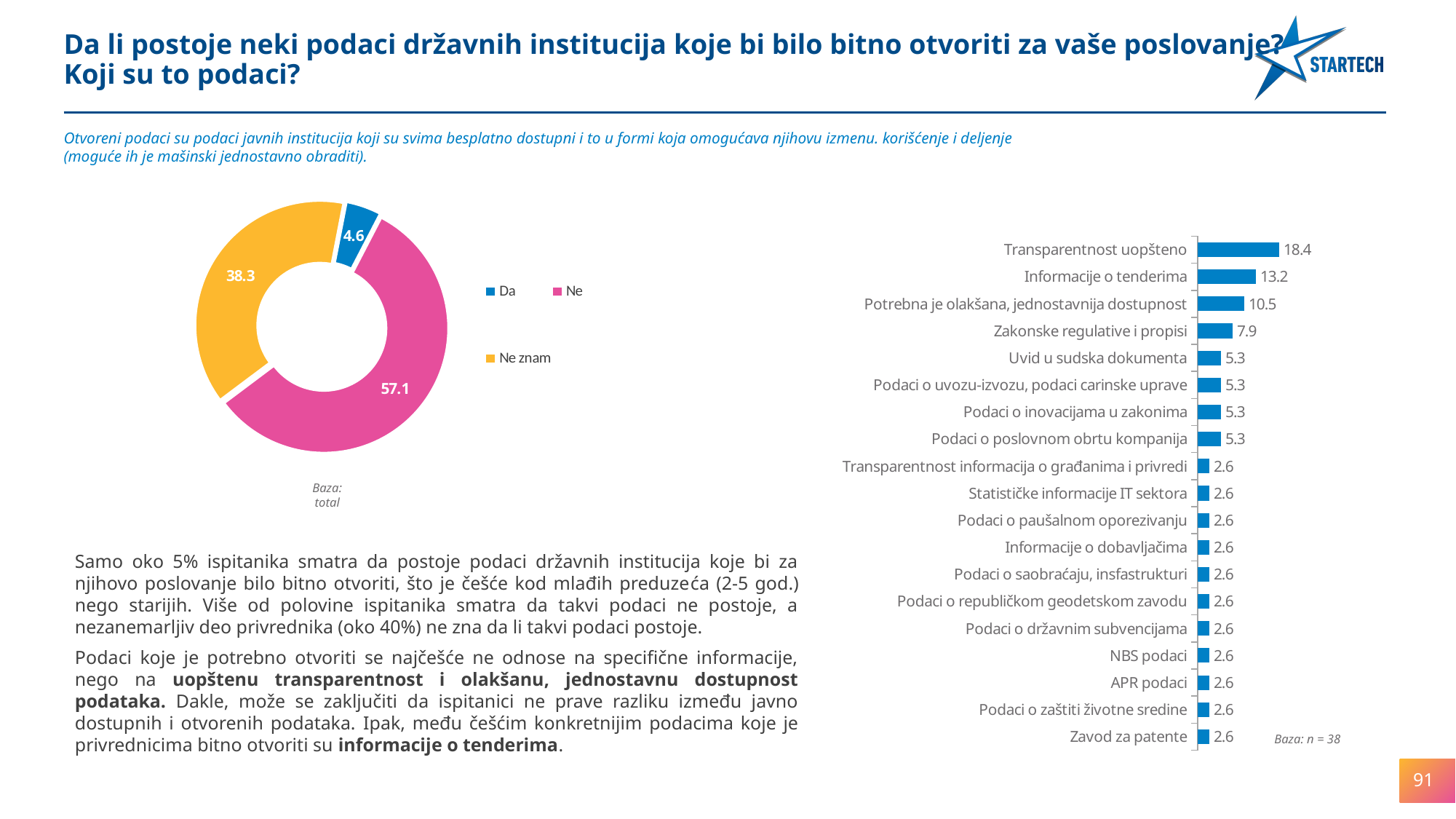
In the donut chart on the left, what is the value for "Ne"? 57.1 In the donut chart on the left, what is the difference between the values for "Ne" and "Ne znam"? 18.8 In the bar chart on the right, what is the value for "Zakonske regulative i propisi"? 7.9 How many categories are shown in the bar chart on the right? 19 What kind of chart is the chart on the right side of the slide? Bar chart In the donut chart on the left, which category has the smallest share? Da In the bar chart on the right, which is larger: "Uvid u sudska dokumenta" or "NBS podaci"? Uvid u sudska dokumenta In the bar chart on the right, what is the difference between "Transparentnost uopšteno" and "Potrebna je olakšana, jednostavnija dostupnost"? 7.9 In the donut chart on the left, what is the value for "Da"? 4.6 How many entries does the legend of the donut chart on the left list? 3 In the bar chart on the right, what is the value for "Informacije o tenderima"? 13.2 In the bar chart on the right, which category has the highest value? Transparentnost uopšteno